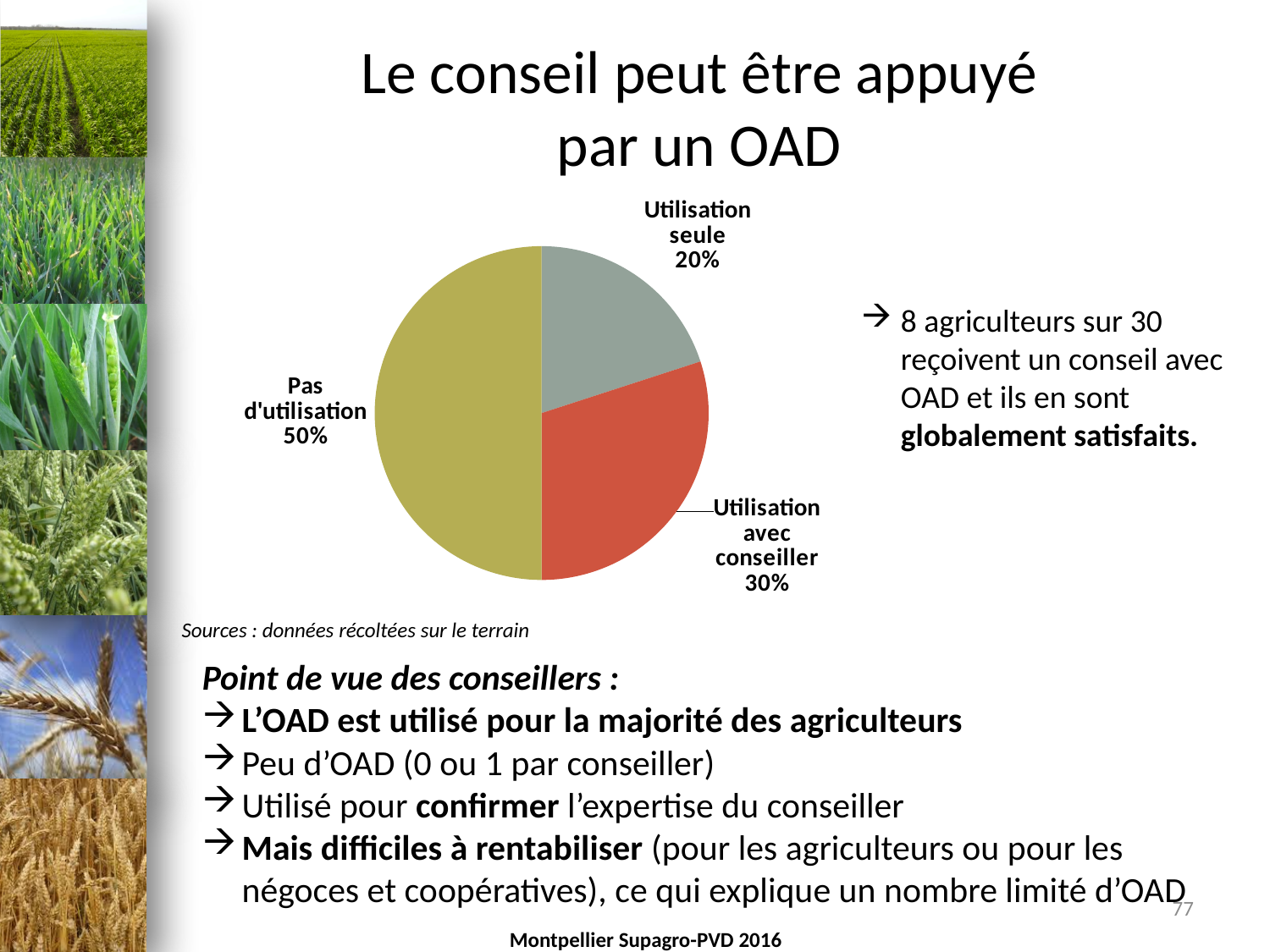
What colour is the "Pas d'utilisation" slice? olive/yellow-green How many slices does the pie chart have? 3 Which slice of the pie is the smallest? Utilisation seule What is the combined share of "Utilisation seule" and "Utilisation avec conseiller"? 50% Which is larger: "Utilisation avec conseiller" or "Utilisation seule"? Utilisation avec conseiller What source is cited below the chart? Sources : données récoltées sur le terrain What share of the pie does "Pas d'utilisation" represent? 50% What is the difference in percentage points between "Pas d'utilisation" and "Utilisation avec conseiller"? 20 Which slice of the pie is the largest? Pas d'utilisation What share of the pie does "Utilisation seule" represent? 20% What kind of chart is shown on the slide? pie chart What share of the pie does "Utilisation avec conseiller" represent? 30%